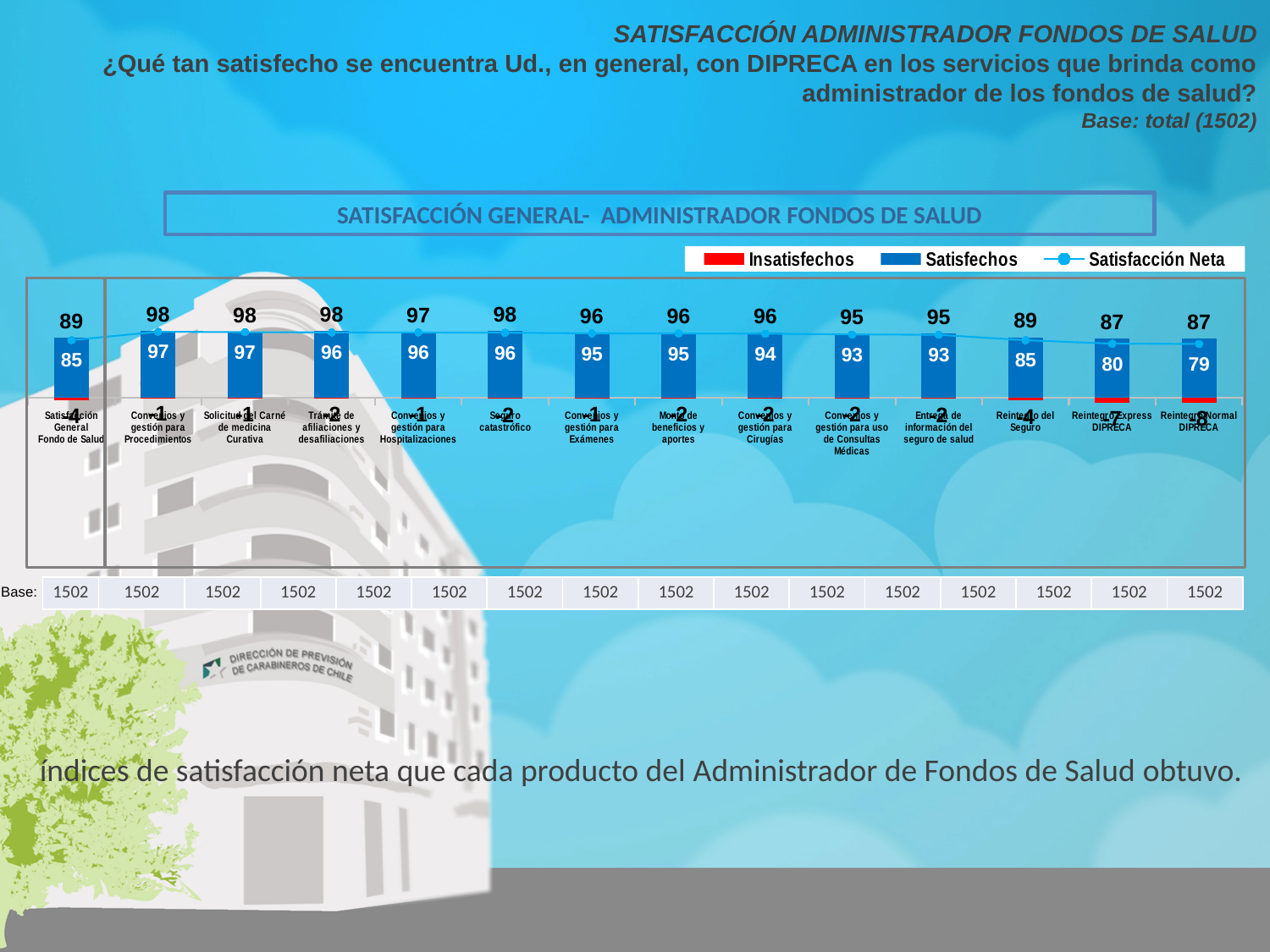
Which category has the lowest Satisfechos value? Reintegro Express DIPRECA and Reintegro Normal DIPRECA (tied at 87) Which has a higher Satisfechos value, Convenios y gestión para Exámenes or Reintegro del Seguro? Convenios y gestión para Exámenes Do the Satisfacción Neta values generally rise or fall from left to right across the categories after Satisfacción General Fondo de Salud? Fall What is the Satisfacción Neta value for Satisfacción General Fondo de Salud? 85 What kind of chart is used to show the Satisfechos values? Bar chart What is the difference between the Satisfechos values for Convenios y gestión para Cirugías and Reintegro Normal DIPRECA? 9 What is the Satisfechos value for Convenios y gestión para Procedimientos? 98 How many series does the legend list? 3 What is the Satisfechos value for Seguro catastrófico? 98 How many categories are shown on the x axis of the chart? 14 What colour represents the Insatisfechos series in the legend? Red What is the Satisfacción Neta value for Reintegro Express DIPRECA? 80